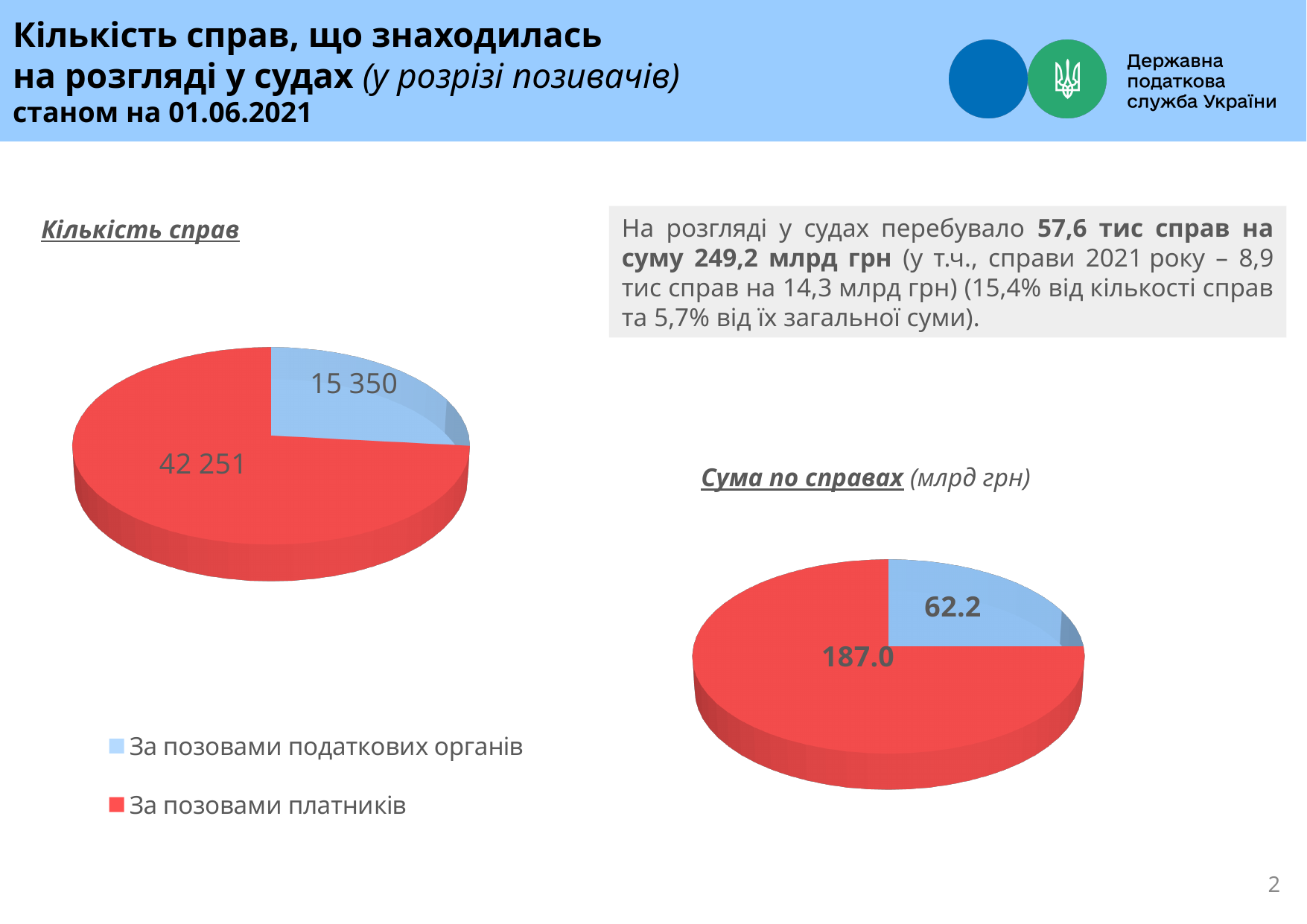
In the 'Кількість справ' chart, what is the difference between the values for 'За позовами платників' and 'За позовами податкових органів'? 26 901 In the 'Сума по справах' chart, what is the difference between the values for 'За позовами платників' and 'За позовами податкових органів'? 124.8 In the 'Сума по справах' chart, what is the value for 'За позовами платників'? 187.0 In the 'Кількість справ' chart, what is the value for 'За позовами податкових органів'? 15 350 In the 'Кількість справ' chart, which category has the largest slice? За позовами платників What kind of chart is the 'Кількість справ' chart? Pie chart In the 'Сума по справах' chart, what is the total of the two slices? 249.2 Which colour represents 'За позовами податкових органів' in the legend? Blue How many slices does the 'Сума по справах' chart have? 2 In the 'Кількість справ' chart, what is the value for 'За позовами платників'? 42 251 In the 'Сума по справах' chart, what is the value for 'За позовами податкових органів'? 62.2 In the 'Сума по справах' chart, which category has the smallest slice? За позовами податкових органів